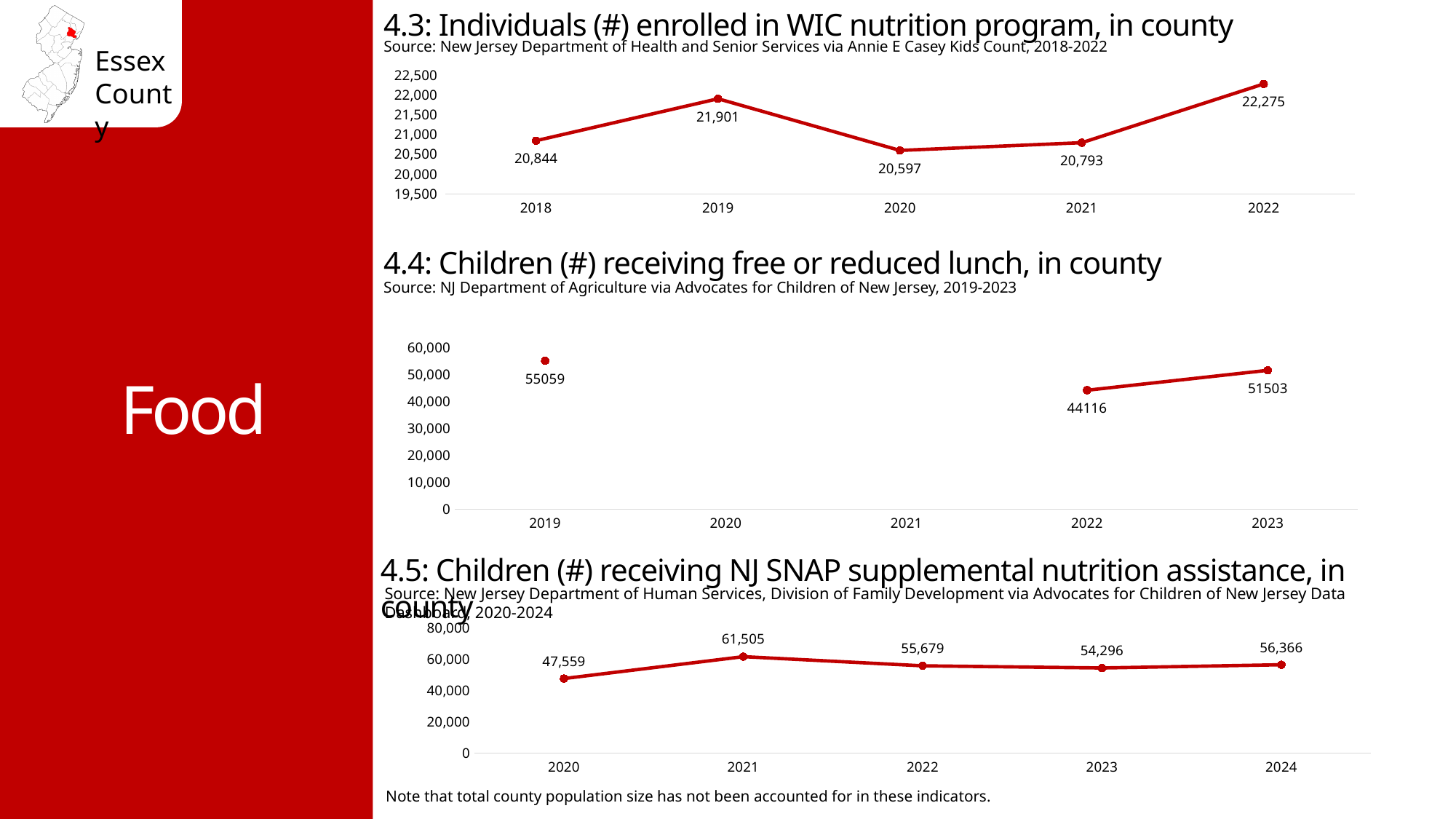
In the chart '4.3: Individuals (#) enrolled in WIC nutrition program, in county', what is the difference between the 2022 and 2018 values? 1,431 In the chart '4.5: Children (#) receiving NJ SNAP supplemental nutrition assistance, in county', what is the value for 2021? 61,505 In the chart '4.3: Individuals (#) enrolled in WIC nutrition program, in county', how many data points are plotted? 5 In the chart '4.3: Individuals (#) enrolled in WIC nutrition program, in county', which year has the highest value? 2022 In the chart '4.4: Children (#) receiving free or reduced lunch, in county', how many years have a plotted data point? 3 In the chart '4.4: Children (#) receiving free or reduced lunch, in county', what is the value for 2022? 44116 In the chart '4.5: Children (#) receiving NJ SNAP supplemental nutrition assistance, in county', which is larger, the value for 2022 or the value for 2024? 2024 In the chart '4.4: Children (#) receiving free or reduced lunch, in county', is the value for 2019 greater or less than 50,000? greater In the chart '4.5: Children (#) receiving NJ SNAP supplemental nutrition assistance, in county', what is the difference between the 2021 and 2020 values? 13,946 In the chart '4.4: Children (#) receiving free or reduced lunch, in county', which year has the lowest plotted value? 2022 What type of chart is '4.5: Children (#) receiving NJ SNAP supplemental nutrition assistance, in county'? line chart In the chart '4.3: Individuals (#) enrolled in WIC nutrition program, in county', what is the value for 2020? 20,597